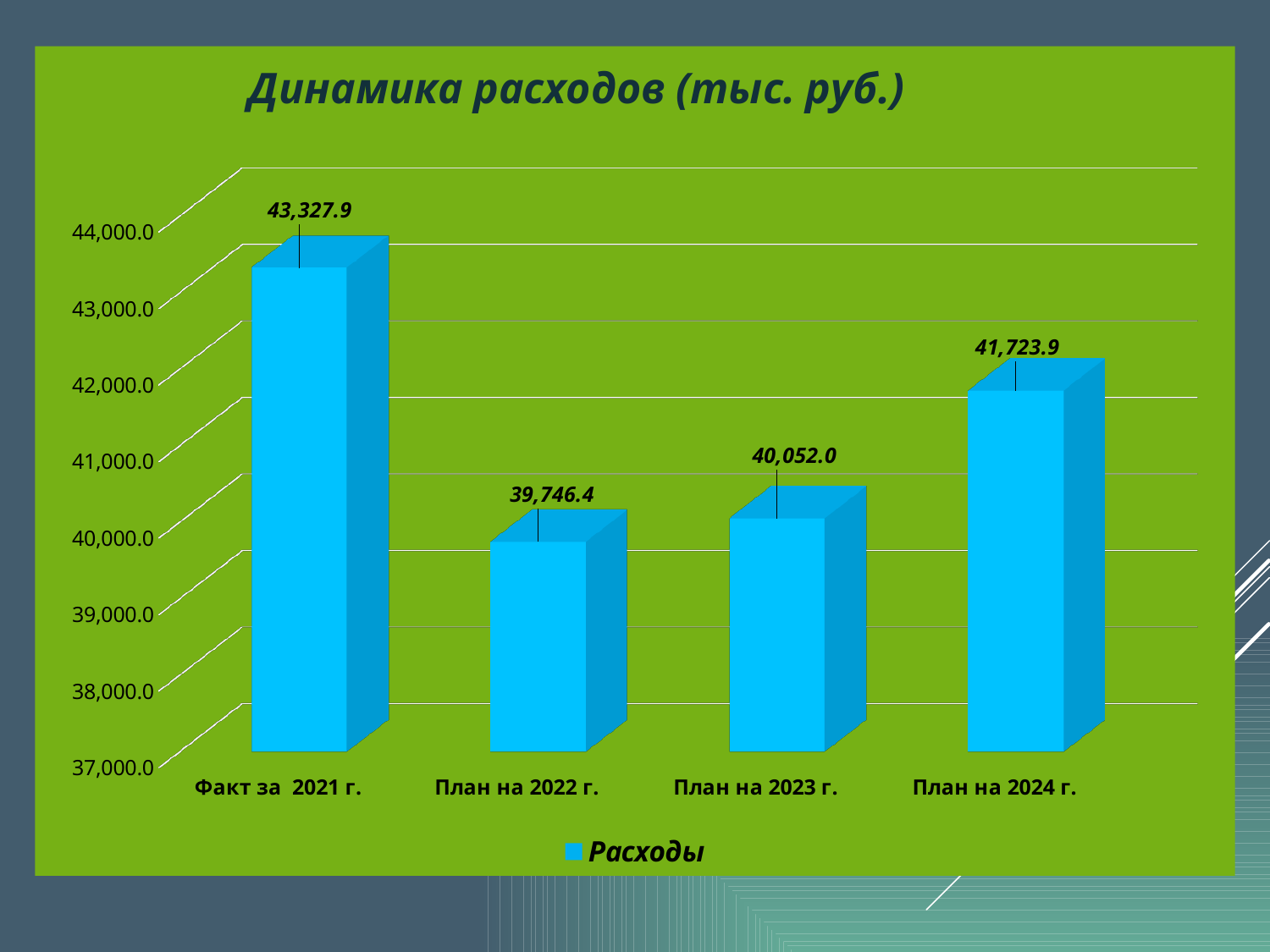
Which category has the highest value? Факт за 2021 г. What is the difference between the values for Факт за 2021 г. and План на 2022 г.? 3,581.5 What is the value for Факт за 2021 г.? 43,327.9 What is the value for План на 2023 г.? 40,052.0 What kind of chart is shown on the slide? Bar chart What is the difference between the values for План на 2024 г. and План на 2023 г.? 1,671.9 What is the value for План на 2024 г.? 41,723.9 How many categories are shown on the x axis? 4 What is the title of the chart? Динамика расходов (тыс. руб.) What is the value for План на 2022 г.? 39,746.4 Which is larger, the value for План на 2023 г. or the value for План на 2024 г.? План на 2024 г. Which category has the lowest value? План на 2022 г.